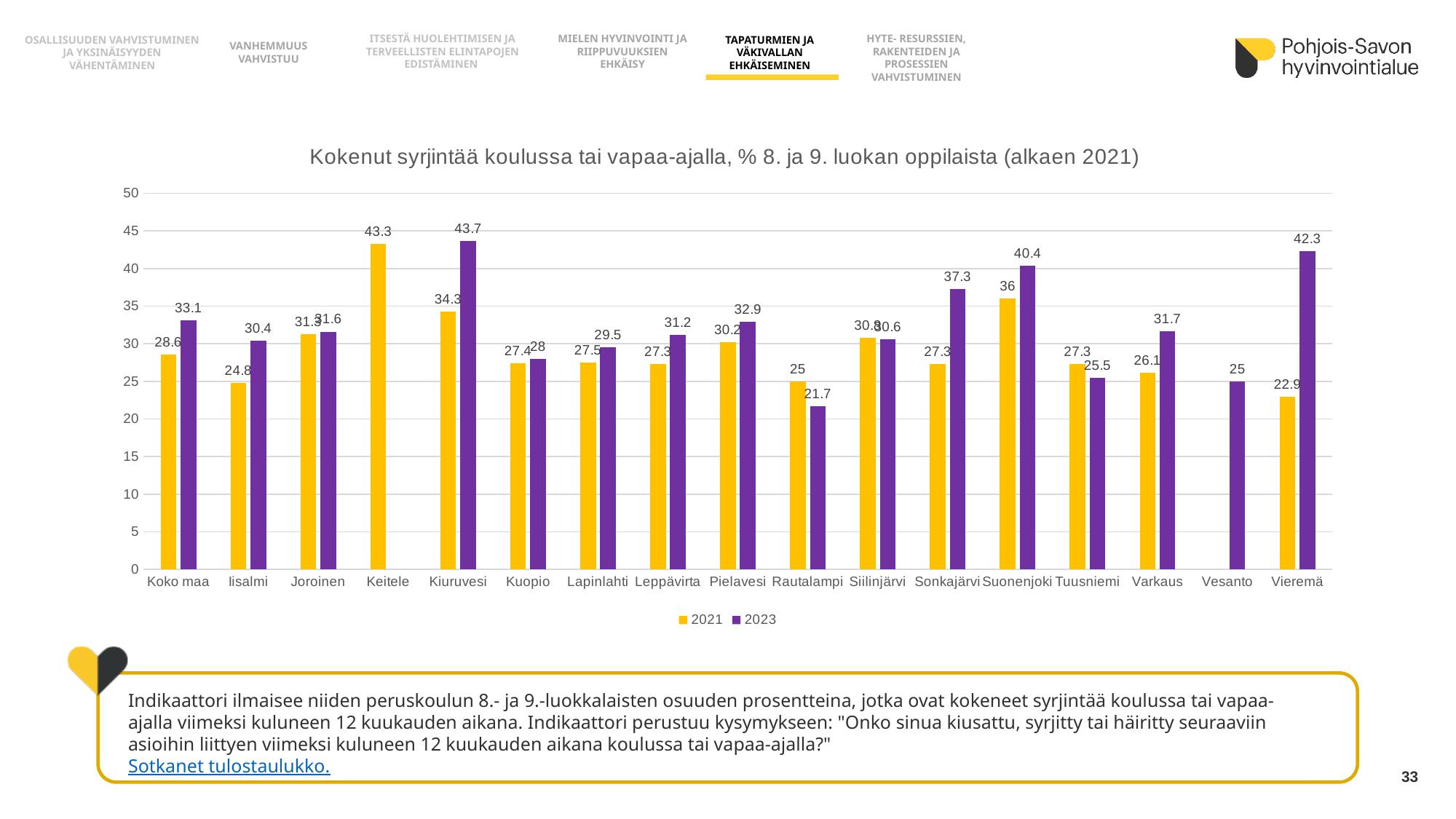
What is the 2023 value for Sonkajärvi? 37.3 What is the difference between the 2023 and 2021 values for Vieremä? 19.4 How many series does the legend list? 2 How many municipalities/categories are shown on the x axis? 17 What kind of chart is shown on the slide? Bar chart What is the 2023 value for Vieremä? 42.3 Which municipality has the highest 2023 value? Kiuruvesi What is the difference between the 2023 and 2021 values for Koko maa? 4.5 Which category has the lowest 2023 value? Rautalampi Which is larger for Rautalampi, the 2021 value or the 2023 value? 2021 What is the 2021 value for Keitele? 43.3 Is the 2023 value for Suonenjoki greater or less than 40? greater